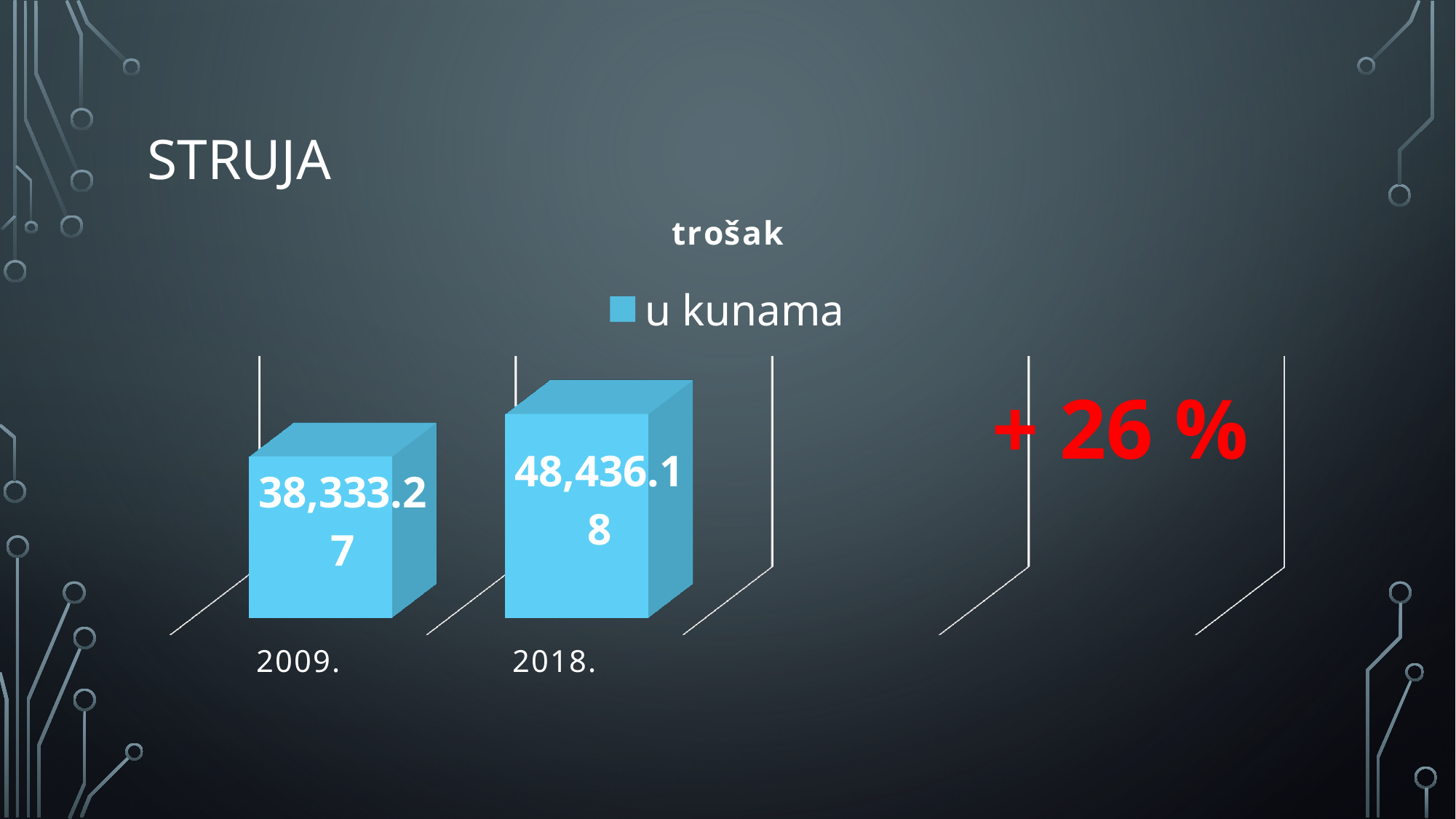
Is the value for 2018. larger or smaller than the value for 2009.? larger Do the values rise or fall from 2009. to 2018.? rise How many series does the chart legend list? 1 What is the title of the chart? trošak What is the name of the series in the chart legend? u kunama What is the value for 2018. in the chart? 48,436.18 Which year has the lower value in the chart? 2009. What is the value for 2009. in the chart? 38,333.27 What kind of chart is shown on the slide? bar chart What is the difference between the values for 2018. and 2009.? 10,102.91 How many categories are shown on the x axis of the chart? 2 Which year has the higher value in the chart? 2018.